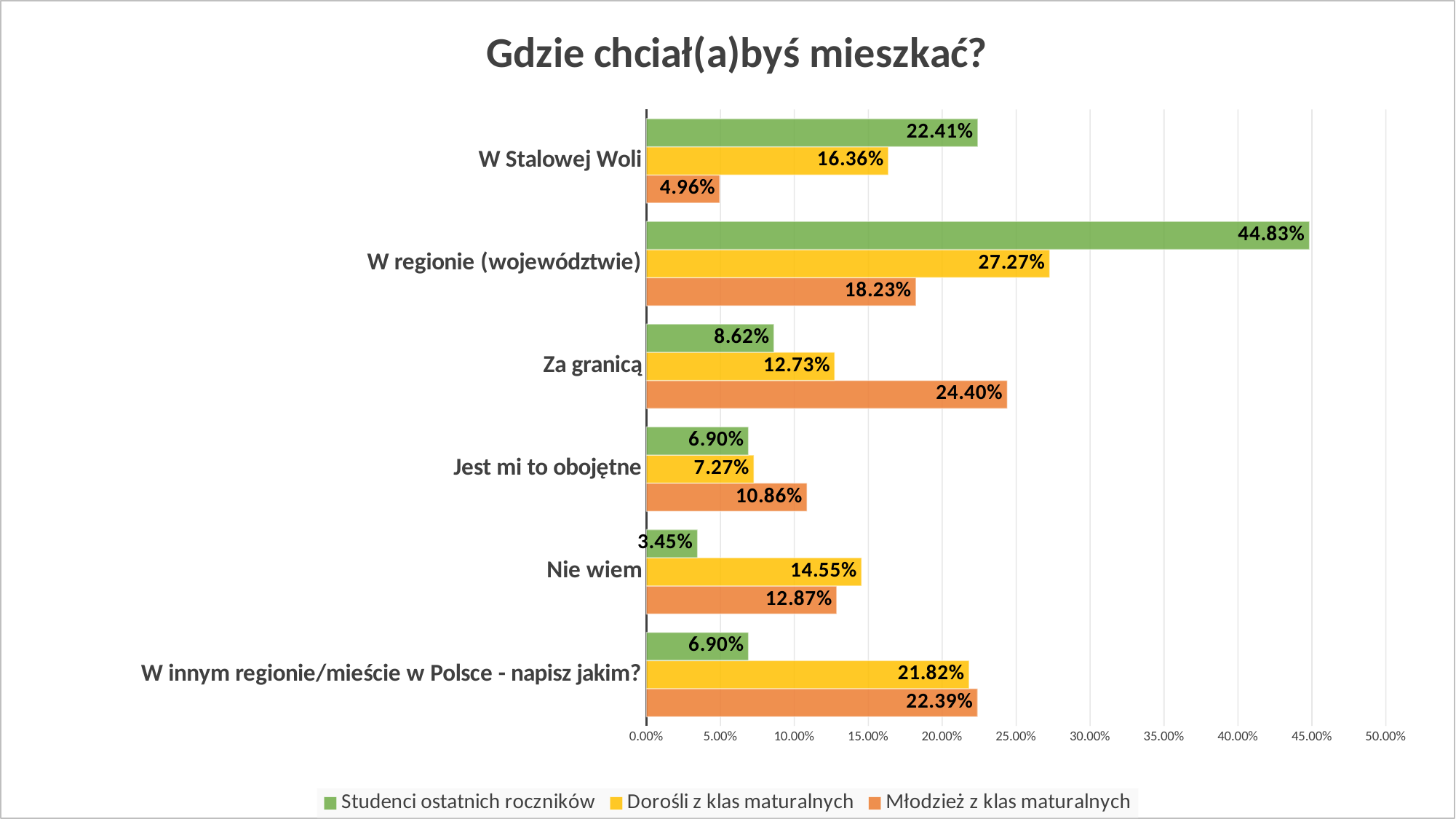
What is the value for Studenci ostatnich roczników in the category W regionie (województwie)? 44.83% Which category has the highest value for Studenci ostatnich roczników? W regionie (województwie) Which category has the lowest value for Młodzież z klas maturalnych? W Stalowej Woli How many series does the legend list? 3 What type of chart is shown on the slide? Bar chart Is the value for Dorośli z klas maturalnych in W regionie (województwie) greater or less than 25.00%? greater How many categories are shown on the chart? 6 What is the difference between the Studenci ostatnich roczników and Młodzież z klas maturalnych values for W Stalowej Woli? 17.45% For Za granicą, which series has the larger value: Studenci ostatnich roczników or Młodzież z klas maturalnych? Młodzież z klas maturalnych What is the value for Dorośli z klas maturalnych in the category Nie wiem? 14.55% What is the value for Młodzież z klas maturalnych in the category Za granicą? 24.40% What is the title of the chart? Gdzie chciał(a)byś mieszkać?